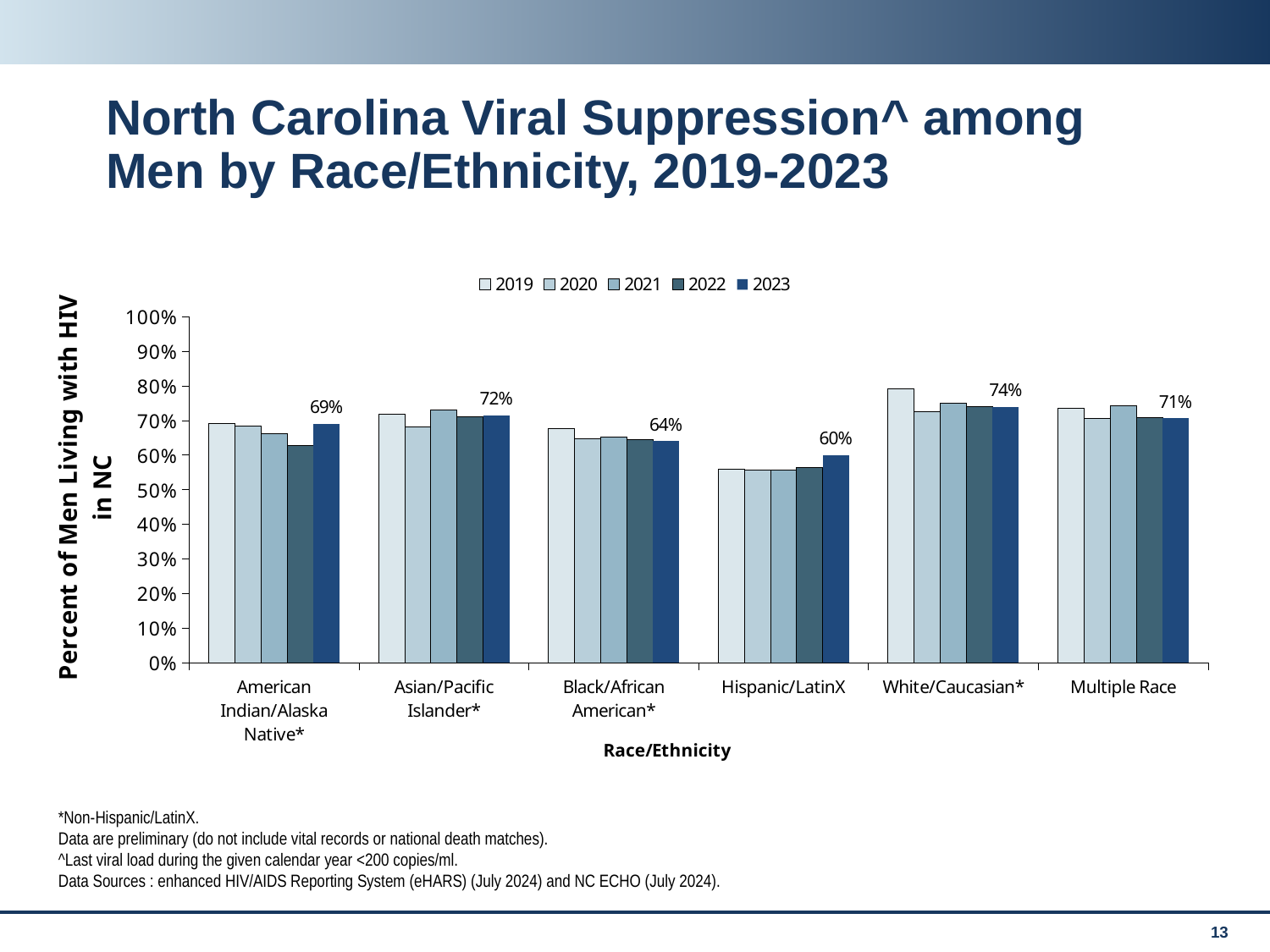
Which race/ethnicity group has the lowest 2023 value? Hispanic/LatinX In 2023, which group has the larger value: Asian/Pacific Islander* or Multiple Race? Asian/Pacific Islander* What is the 2023 value shown for Black/African American* men? 64% What is the 2023 viral suppression value for Hispanic/LatinX men? 60% What kind of chart is shown on the slide? Bar chart How many race/ethnicity categories are shown on the x axis? 6 Is the 2019 value for White/Caucasian* men greater or less than 70%? greater What is the 2023 value shown for White/Caucasian* men? 74% How many years (series) does the legend list? 5 What is the difference between the 2023 values for White/Caucasian* and Hispanic/LatinX men? 14 percentage points Which race/ethnicity group has the highest 2023 value? White/Caucasian* Is the 2019 value for Hispanic/LatinX men greater or less than 60%? less